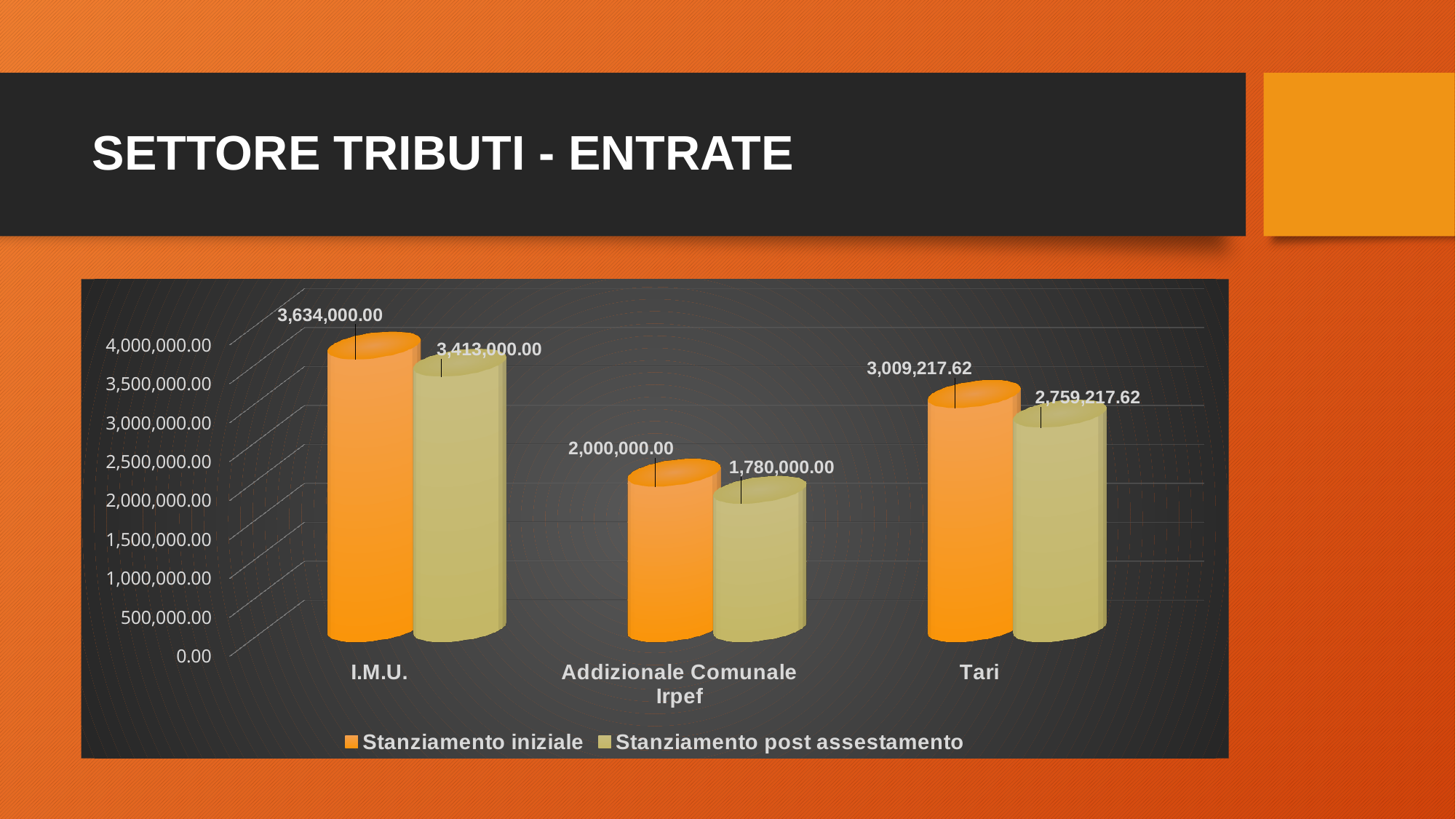
What is the difference between the Stanziamento iniziale and Stanziamento post assestamento values for I.M.U.? 221,000.00 How many categories are shown on the x axis of the chart? 3 Which is larger: the Stanziamento iniziale value for Tari or the Stanziamento post assestamento value for I.M.U.? Stanziamento post assestamento value for I.M.U. Which category has the lowest Stanziamento post assestamento value? Addizionale Comunale Irpef What kind of chart is shown on the slide? Bar chart Which category has the highest Stanziamento iniziale value? I.M.U. What is the Stanziamento post assestamento value for Addizionale Comunale Irpef? 1,780,000.00 What is the difference between the Stanziamento iniziale and Stanziamento post assestamento values for Tari? 250,000.00 What is the Stanziamento post assestamento value for Tari? 2,759,217.62 How many series does the chart legend list? 2 Which series is shown in orange in the chart legend? Stanziamento iniziale What is the Stanziamento iniziale value for I.M.U.? 3,634,000.00